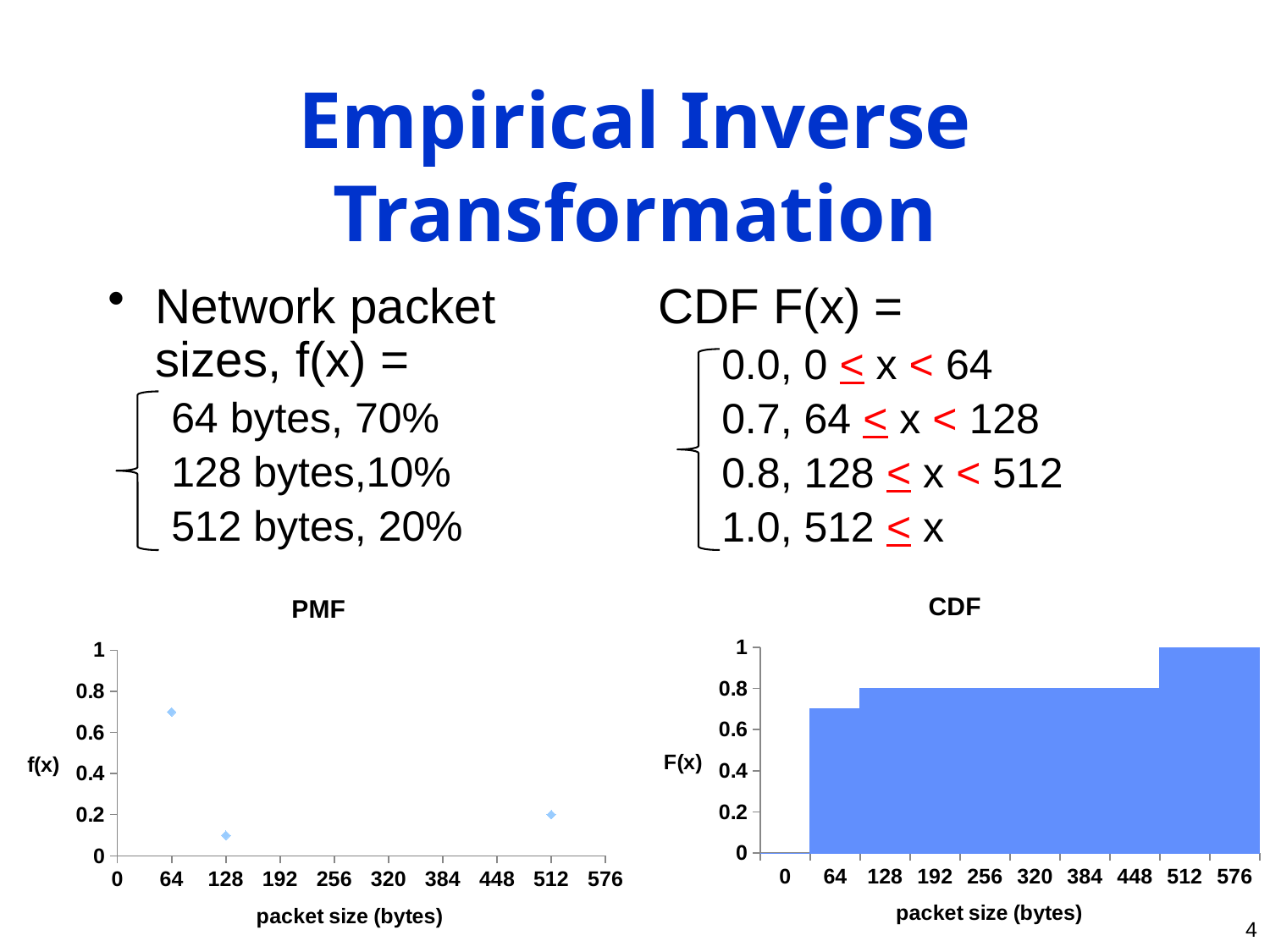
In the PMF chart, what is f(x) for a packet size of 512 bytes? 0.2 What kind of chart is the CDF chart on the right? bar chart What kind of chart is the PMF chart on the left? scatter chart In the PMF chart, which packet size has the lowest f(x)? 128 What is the x-axis title of the CDF chart? packet size (bytes) In the PMF chart, is f(x) for a packet size of 128 bytes greater or less than 0.2? less In the CDF chart, do the values rise or fall as packet size increases? rise In the PMF chart, which has the larger f(x): 64 bytes or 512 bytes? 64 bytes In the PMF chart, is f(x) for a packet size of 64 bytes greater or less than 0.6? greater In the PMF chart, how many data points are plotted? 3 In the PMF chart, which packet size has the highest f(x)? 64 In the CDF chart, what is F(x) at a packet size of 256 bytes? 0.8